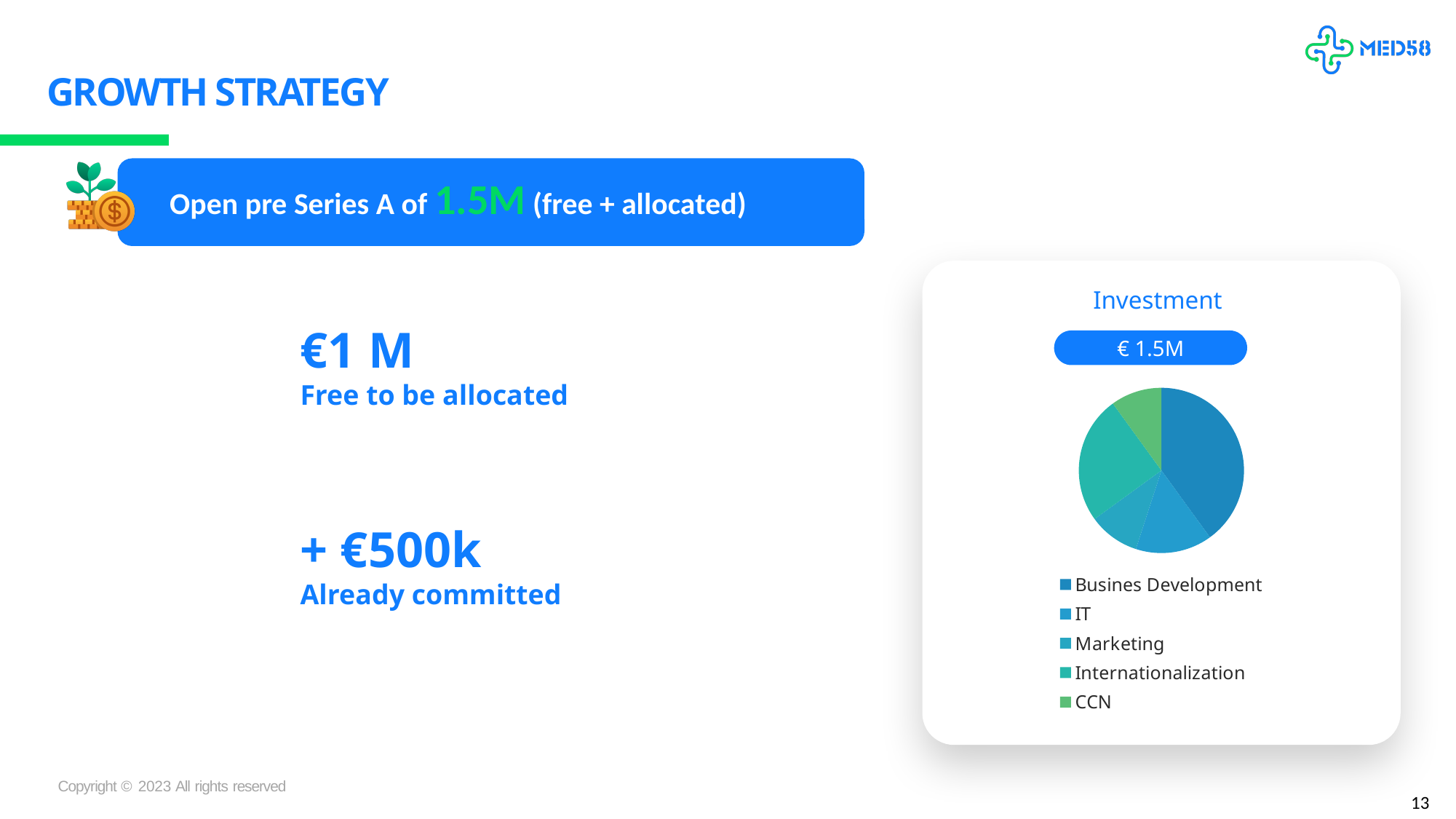
Which category has the largest slice in the Investment pie chart? Busines Development In the Investment pie chart, which slice is larger: Internationalization or IT? Internationalization How many entries does the legend of the Investment pie chart list? 5 In the Investment pie chart, which slice is larger: Busines Development or CCN? Busines Development What total amount is shown in the label above the Investment pie chart? € 1.5M In the Investment pie chart, which slice is larger: Busines Development or Marketing? Busines Development What is the title of the pie chart? Investment How many slices does the Investment pie chart have? 5 What kind of chart is shown on the slide? pie chart